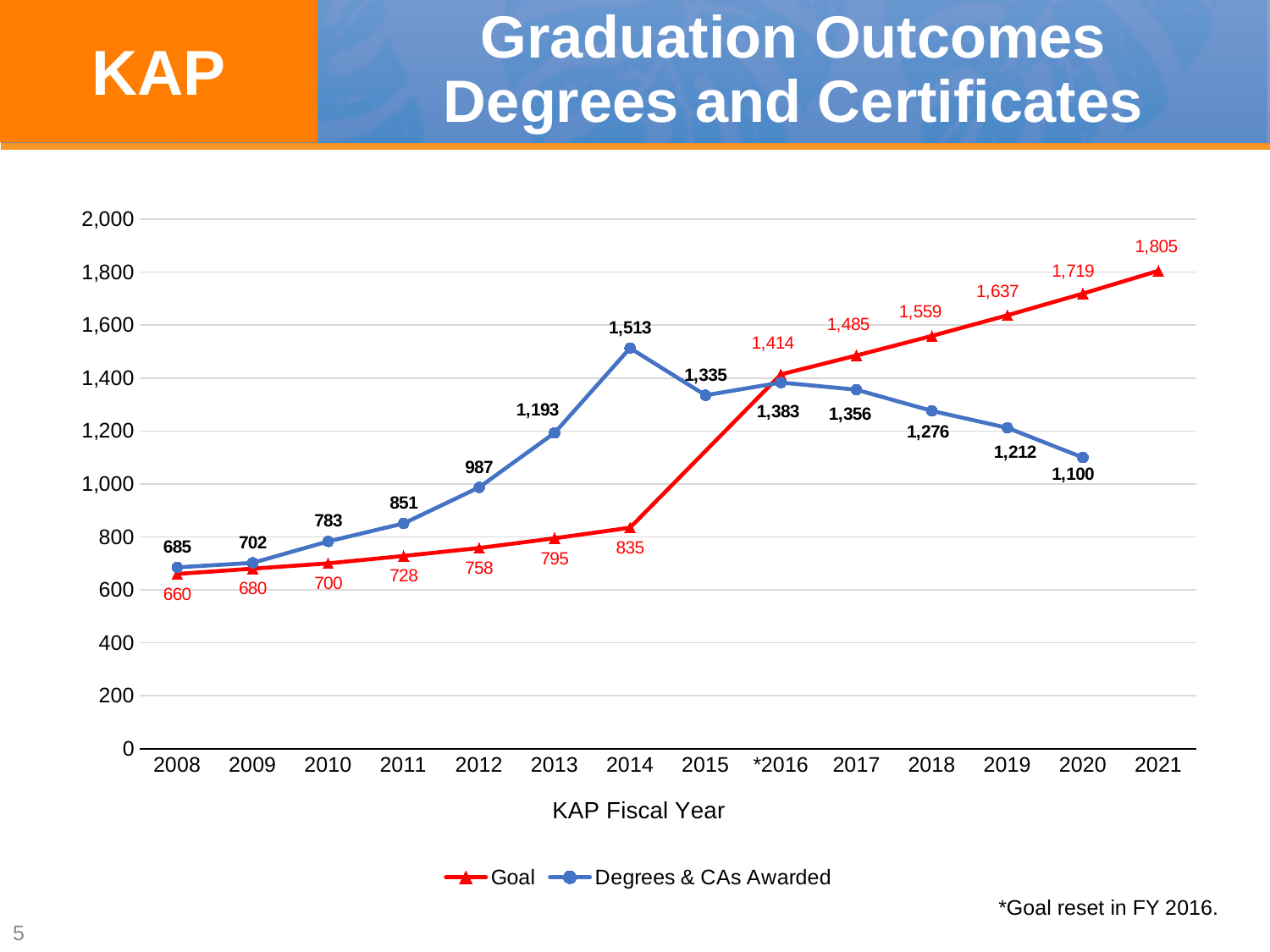
What is the value of Degrees & CAs Awarded in 2020? 1,100 What is the value of Degrees & CAs Awarded in 2014? 1,513 Does the Goal series rise or fall from 2016 to 2021? Rises How many series does the legend list? 2 How many fiscal years are shown on the x axis? 14 In 2017, which is larger: the Goal or Degrees & CAs Awarded? Goal In which fiscal year is the Degrees & CAs Awarded series at its lowest? 2008 What is the Goal value for 2021? 1,805 What kind of chart is shown on the slide? Line chart In which fiscal year is the Degrees & CAs Awarded series at its highest? 2014 By how much did Degrees & CAs Awarded exceed the Goal in 2014? 678 What is the title of the x axis? KAP Fiscal Year